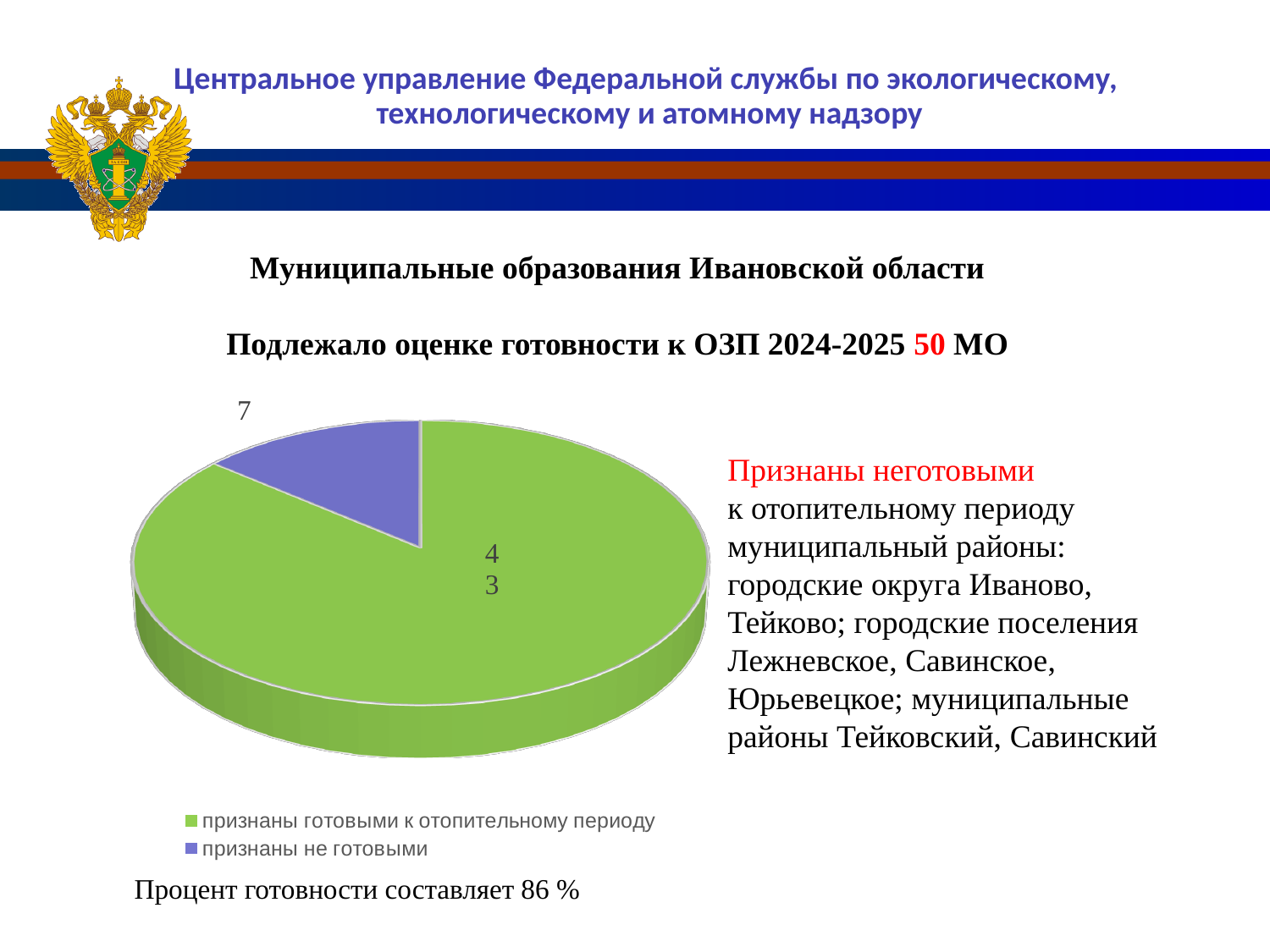
Which slice of the pie chart is the smallest? признаны не готовыми What colour is the slice "признаны не готовыми" in the pie chart? purple What is the value of the slice "признаны готовыми к отопительному периоду"? 43 How many slices does the pie chart have? 2 What is the total of the two slices in the pie chart? 50 Which is larger: the slice "признаны готовыми к отопительному периоду" or the slice "признаны не готовыми"? признаны готовыми к отопительному периоду What is the value of the slice "признаны не готовыми"? 7 Which slice of the pie chart is the largest? признаны готовыми к отопительному периоду How many entries does the legend of the pie chart list? 2 What is the difference between the number of municipalities recognised as ready and those recognised as not ready? 36 What kind of chart is shown on the slide? pie chart What share of the pie does the slice "признаны не готовыми" represent? 14%